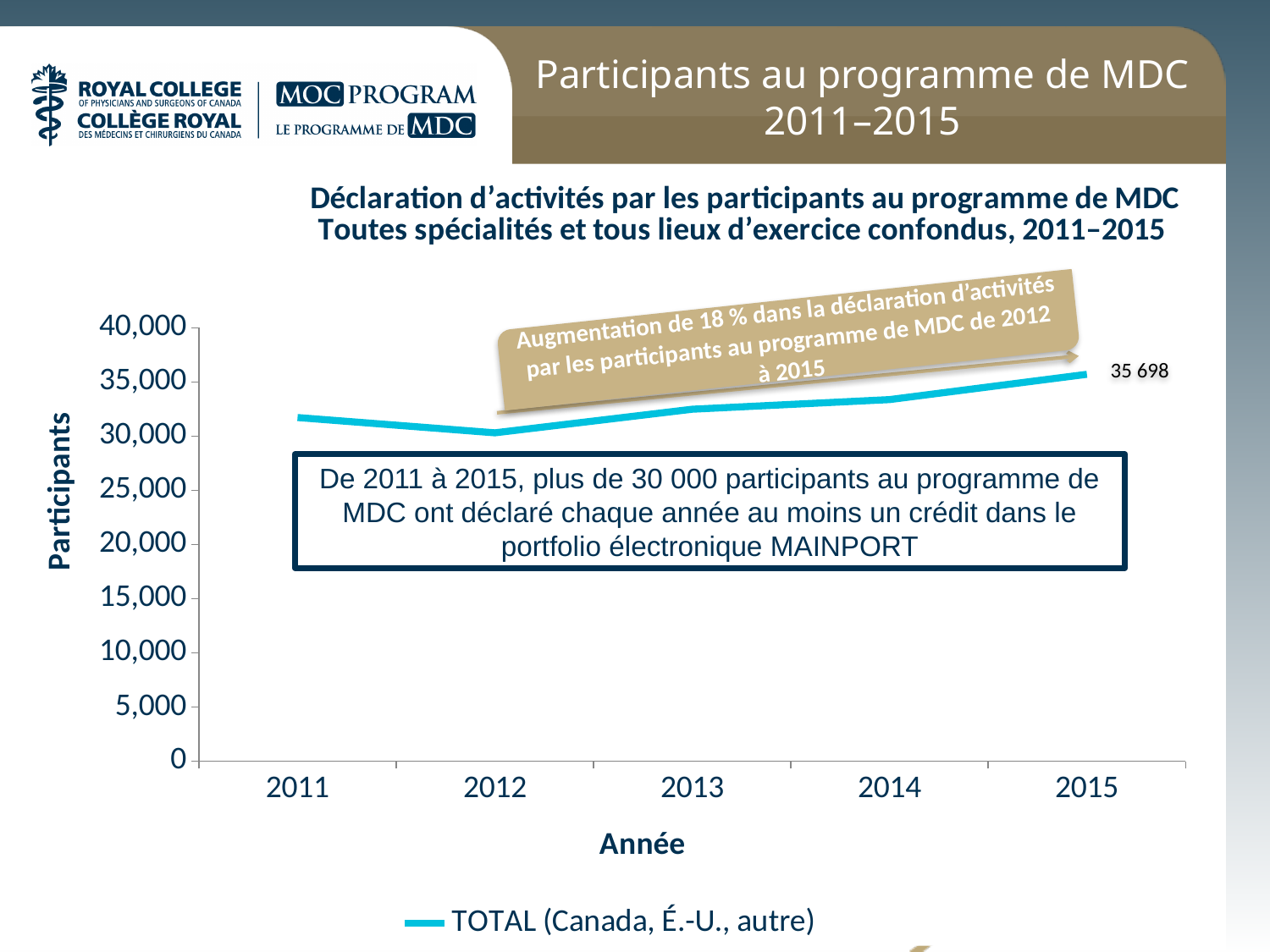
Which year has the lowest number of participants? 2012 Do the values rise or fall from 2012 to 2015? rise Is the value for 2015 greater or less than 35,000? greater Which year has more participants, 2012 or 2015? 2015 Is the value for 2011 greater or less than 30,000? greater What is the label of the series in the legend? TOTAL (Canada, É.-U., autre) Is the value for 2012 greater or less than 35,000? less Which year has the highest number of participants? 2015 What kind of chart is shown on the slide? line chart What is the value for 2015 on the chart? 35 698 How many years are plotted on the x axis? 5 How many series does the legend list? 1